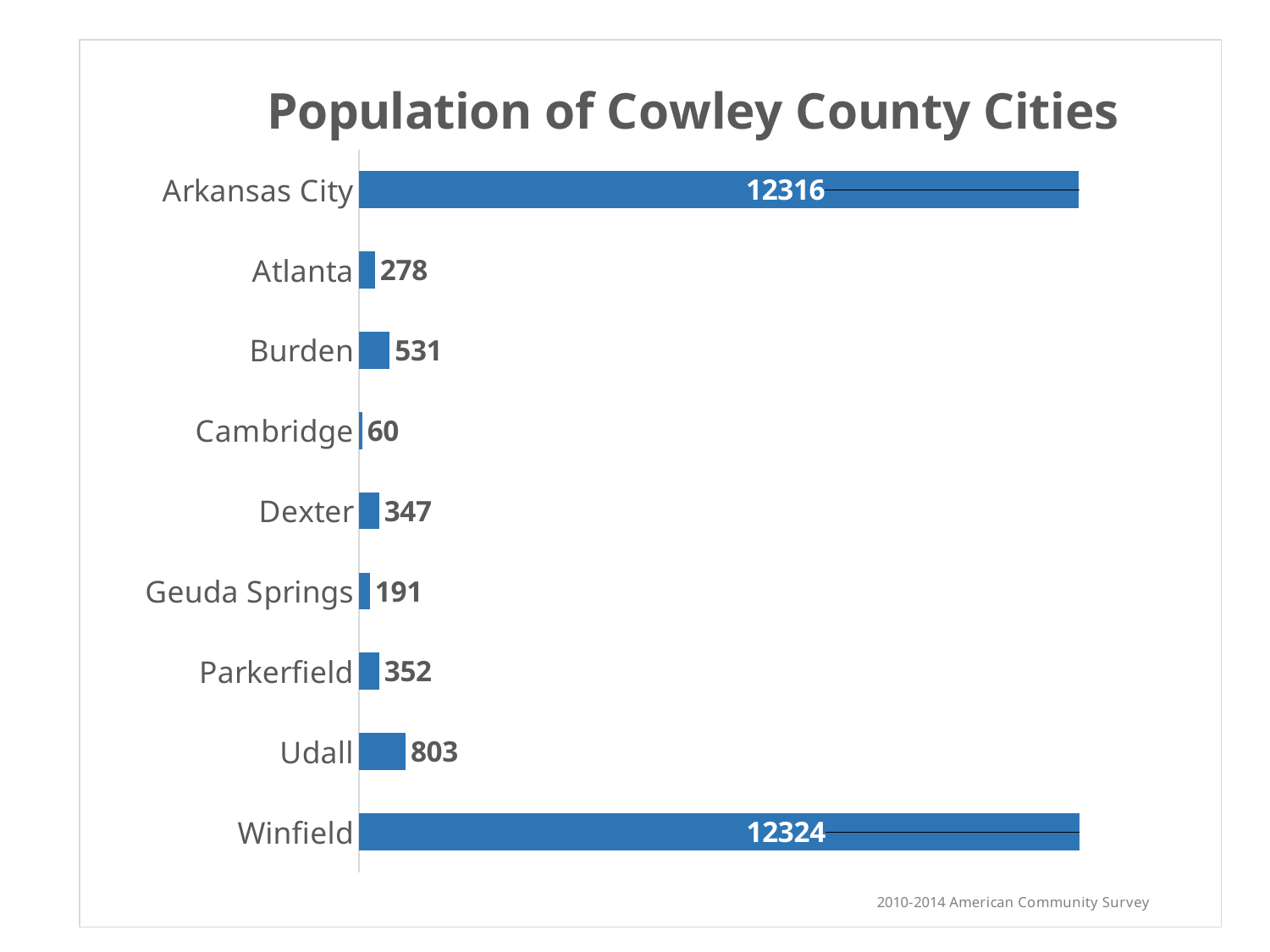
What type of chart is shown on the slide? Bar chart How many cities are shown in the chart? 9 What is the title of the chart? Population of Cowley County Cities What is the population of Winfield? 12324 What is the population of Udall? 803 What is the population of Arkansas City? 12316 Which has a larger population, Udall or Burden? Udall What is the difference in population between Winfield and Arkansas City? 8 What is the difference in population between Udall and Burden? 272 What data source is cited at the bottom of the chart? 2010-2014 American Community Survey What is the population of Geuda Springs? 191 Which city has the smallest population? Cambridge